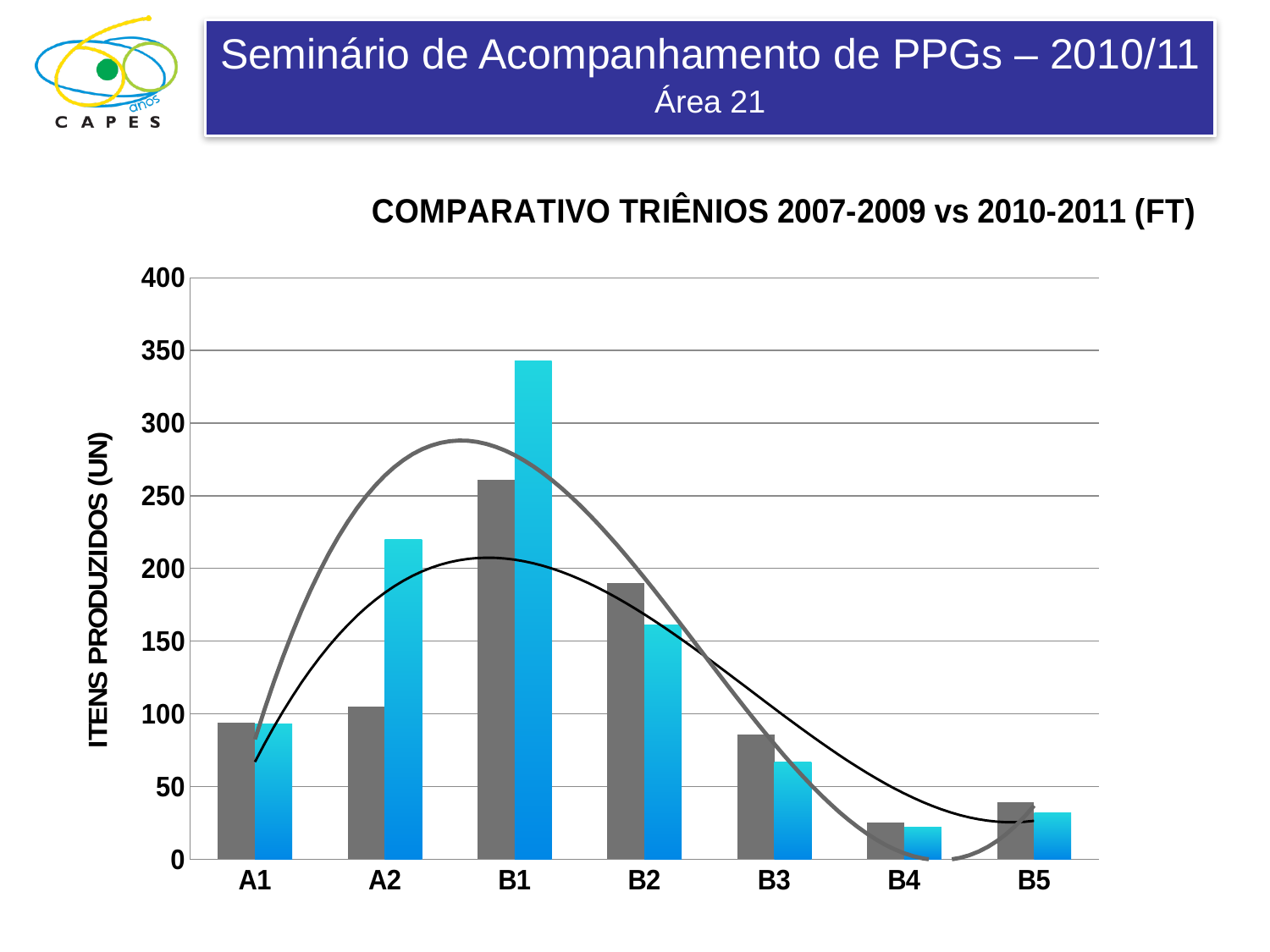
What is the label of the vertical axis of the chart? ITENS PRODUZIDOS (UN) Is the value of the gray bar for B1 greater or less than 250? greater Which category has the tallest blue bar? B1 How many categories are shown on the x axis of the chart? 7 Which category has the tallest gray bar? B1 For category B2, which bar is taller, the gray bar or the blue bar? the gray bar What kind of chart is shown on the slide? bar chart Which category has the shortest gray bar? B4 Is the value of the blue bar for B1 greater or less than 300? greater Is the value of the blue bar for A2 greater or less than 200? greater What is the title of the chart? COMPARATIVO TRIÊNIOS 2007-2009 vs 2010-2011 (FT)